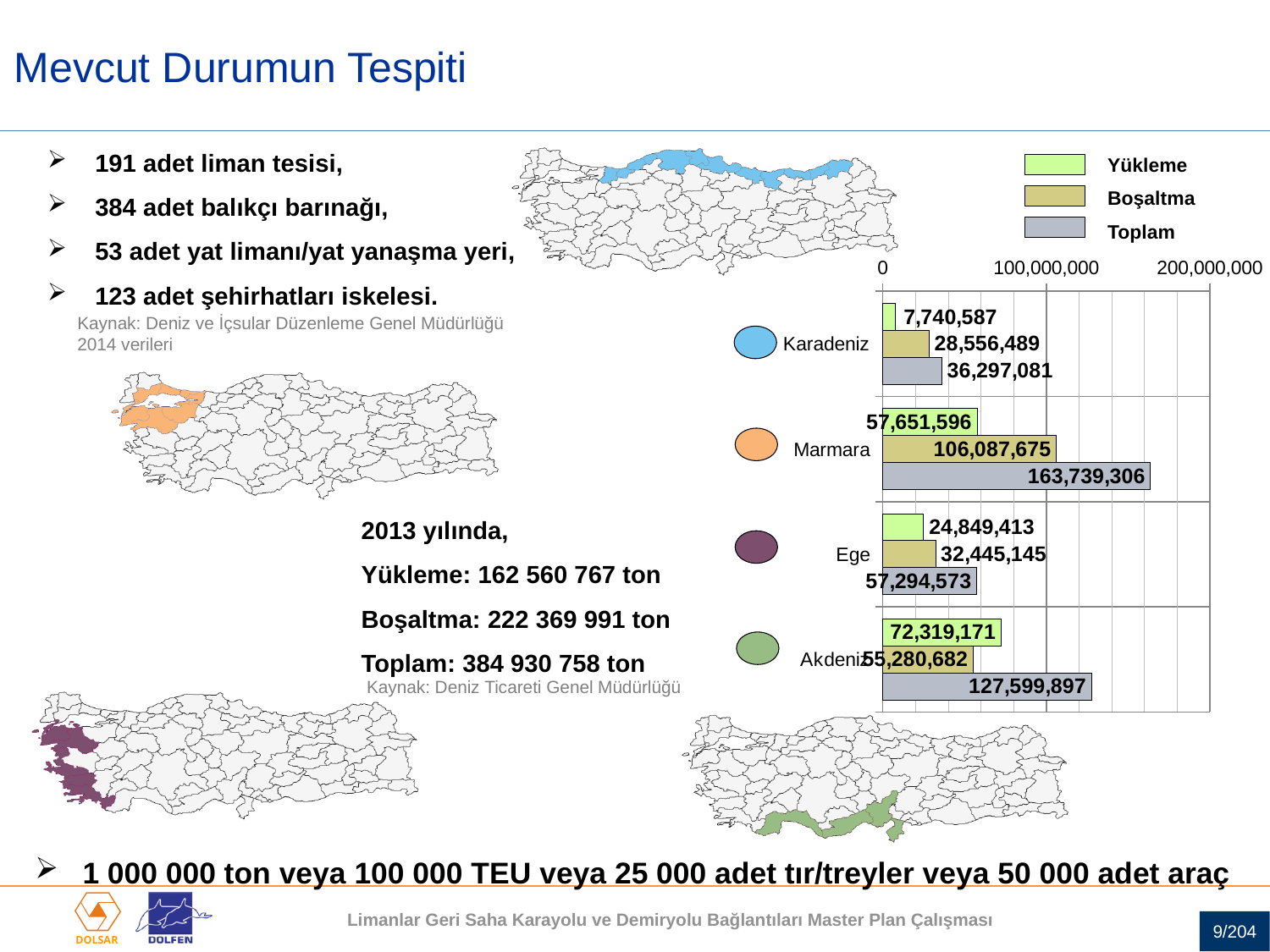
Which region has the highest Toplam value? Marmara What kind of chart is shown on the slide? bar chart What is the Boşaltma value for Ege? 32,445,145 Which region has the lowest Yükleme value? Karadeniz Which is larger for Akdeniz, Yükleme or Boşaltma? Yükleme What is the difference between the Toplam values of Marmara and Karadeniz? 127,442,225 What is the Toplam value for Akdeniz? 127,599,897 How many series does the legend list? 3 Is the Toplam value for Marmara greater or less than 100,000,000? greater What is the Boşaltma value for Marmara? 106,087,675 How many regions are shown on the chart? 4 What is the Yükleme value for Karadeniz? 7,740,587